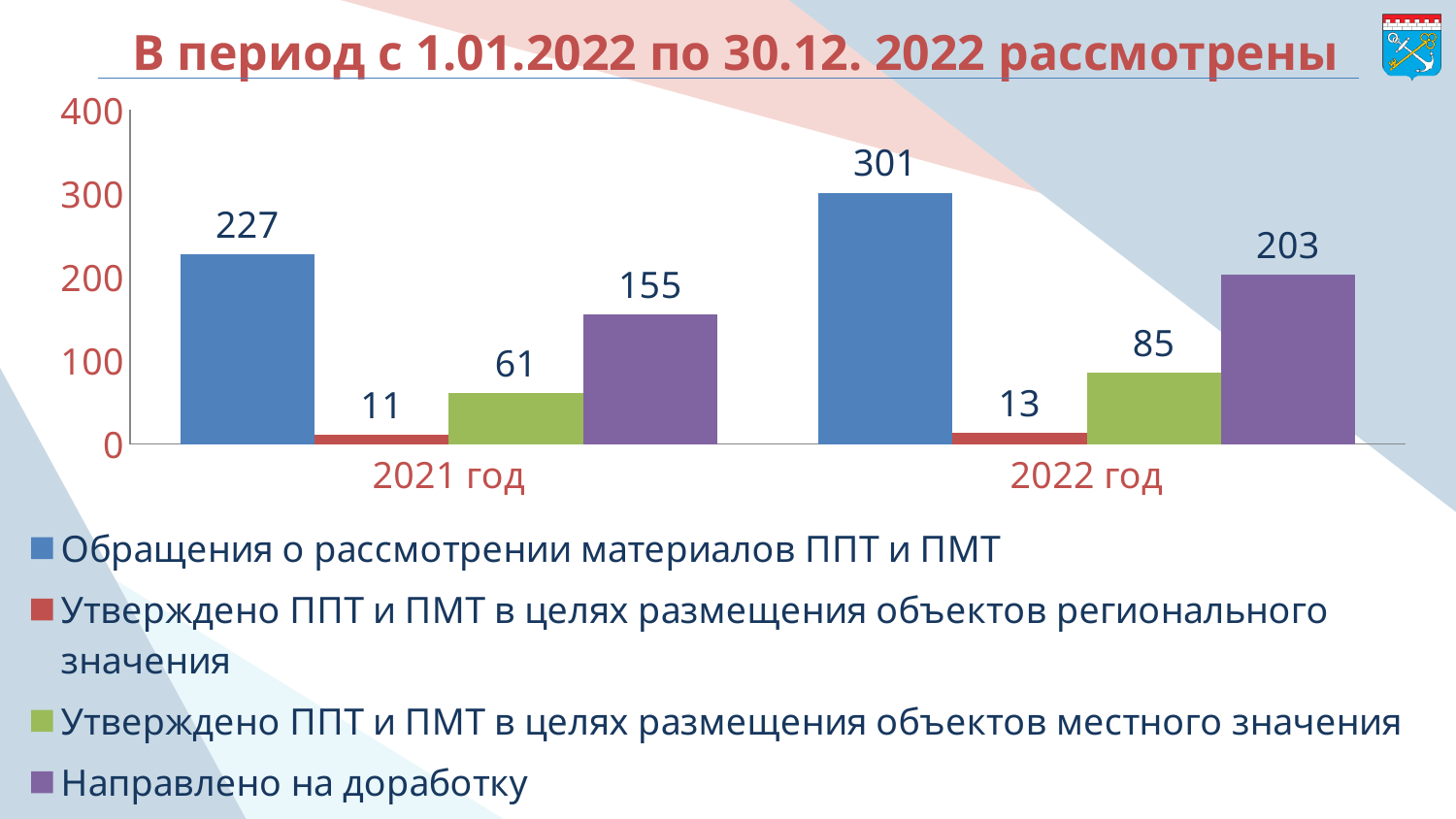
Which series has the lowest value in 2021 год? Утверждено ППТ и ПМТ в целях размещения объектов регионального значения What colour are the bars for 'Направлено на доработку'? Purple What kind of chart is shown on the slide? Bar chart What is the difference between the 'Обращения о рассмотрении материалов ППТ и ПМТ' values for 2022 год and 2021 год? 74 How many series does the legend list? 4 What is the value for 'Утверждено ППТ и ПМТ в целях размещения объектов регионального значения' in 2022 год? 13 Which is larger: 'Направлено на доработку' in 2021 год or 'Утверждено ППТ и ПМТ в целях размещения объектов местного значения' in 2022 год? Направлено на доработку in 2021 год Which series has the highest value in 2022 год? Обращения о рассмотрении материалов ППТ и ПМТ What is the value for 'Обращения о рассмотрении материалов ППТ и ПМТ' in 2021 год? 227 How many categories are shown on the x axis? 2 What is the value for 'Утверждено ППТ и ПМТ в целях размещения объектов местного значения' in 2021 год? 61 What is the value for 'Направлено на доработку' in 2022 год? 203